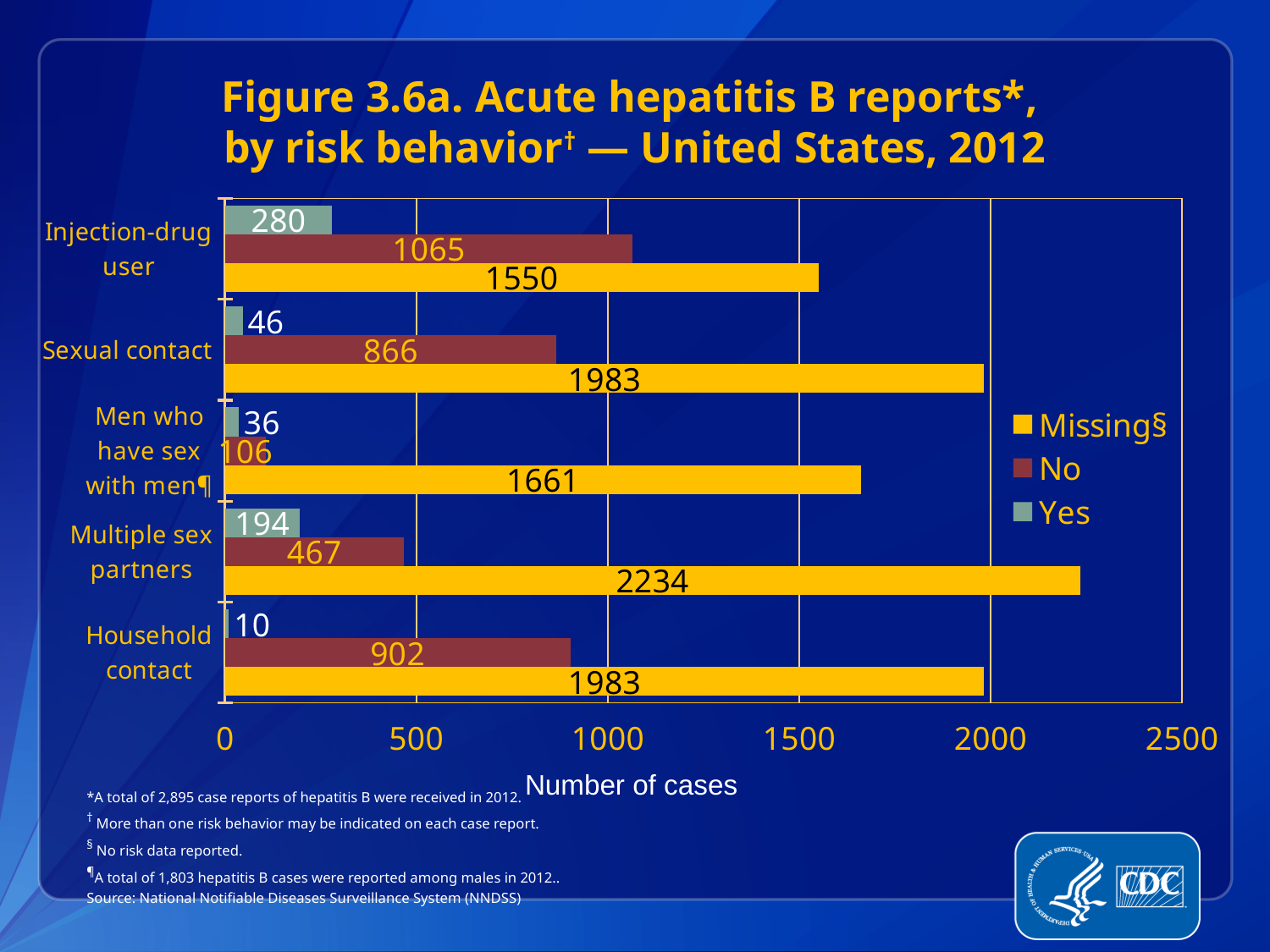
Which risk behavior has the lowest value in the No series? Men who have sex with men How many risk behavior categories are shown on the chart? 5 What is the number of cases for Household contact in the No series? 902 What is the label of the x axis? Number of cases What is the difference between the No values for Injection-drug user and Sexual contact? 199 What kind of chart is shown on the slide? Bar chart What is the number of cases for Men who have sex with men in the Yes series? 36 What is the number of cases for Multiple sex partners in the Missing series? 2234 Which is larger: the Missing value for Injection-drug user or the Missing value for Men who have sex with men? Men who have sex with men Which risk behavior has the highest value in the Yes series? Injection-drug user How many series does the legend list? 3 What is the number of cases for Injection-drug user in the Yes series? 280